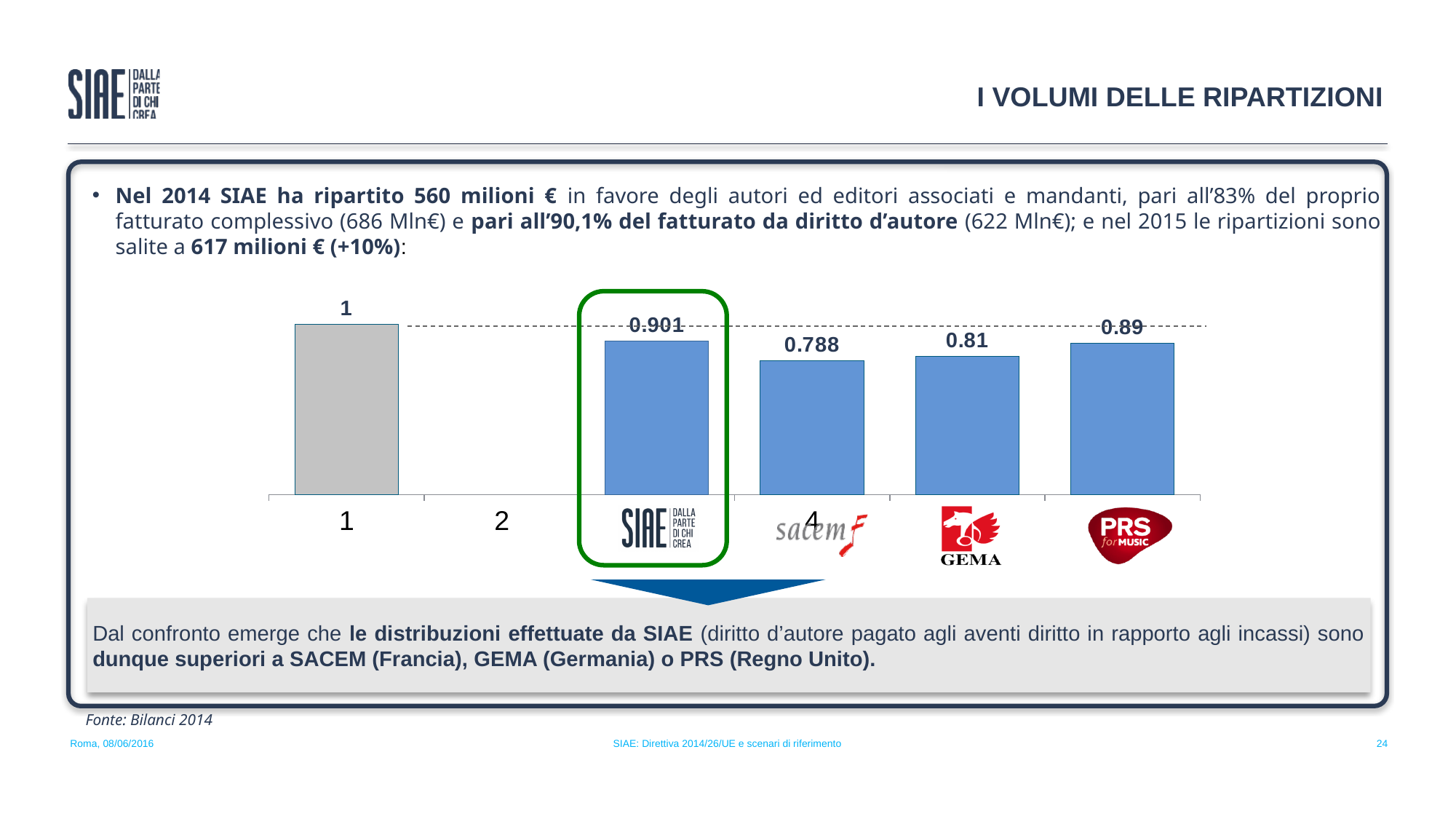
What is the difference between the PRS value and the GEMA value in the bar chart? 0.08 What value is shown for SIAE in the bar chart? 0.901 What value is shown for PRS in the bar chart? 0.89 Among SIAE, SACEM, GEMA and PRS, which has the lowest value in the bar chart? SACEM What value is shown for SACEM in the bar chart? 0.788 Which is larger in the bar chart, the value for GEMA or the value for PRS? PRS Which bar in the chart is highlighted with a green rounded outline? SIAE What is the difference between the SIAE value and the SACEM value in the bar chart? 0.113 What value is shown for GEMA in the bar chart? 0.81 What value is shown for the grey bar labelled 1 in the bar chart? 1 Among SIAE, SACEM, GEMA and PRS, which has the highest value in the bar chart? SIAE What kind of chart is shown on the slide? Bar chart